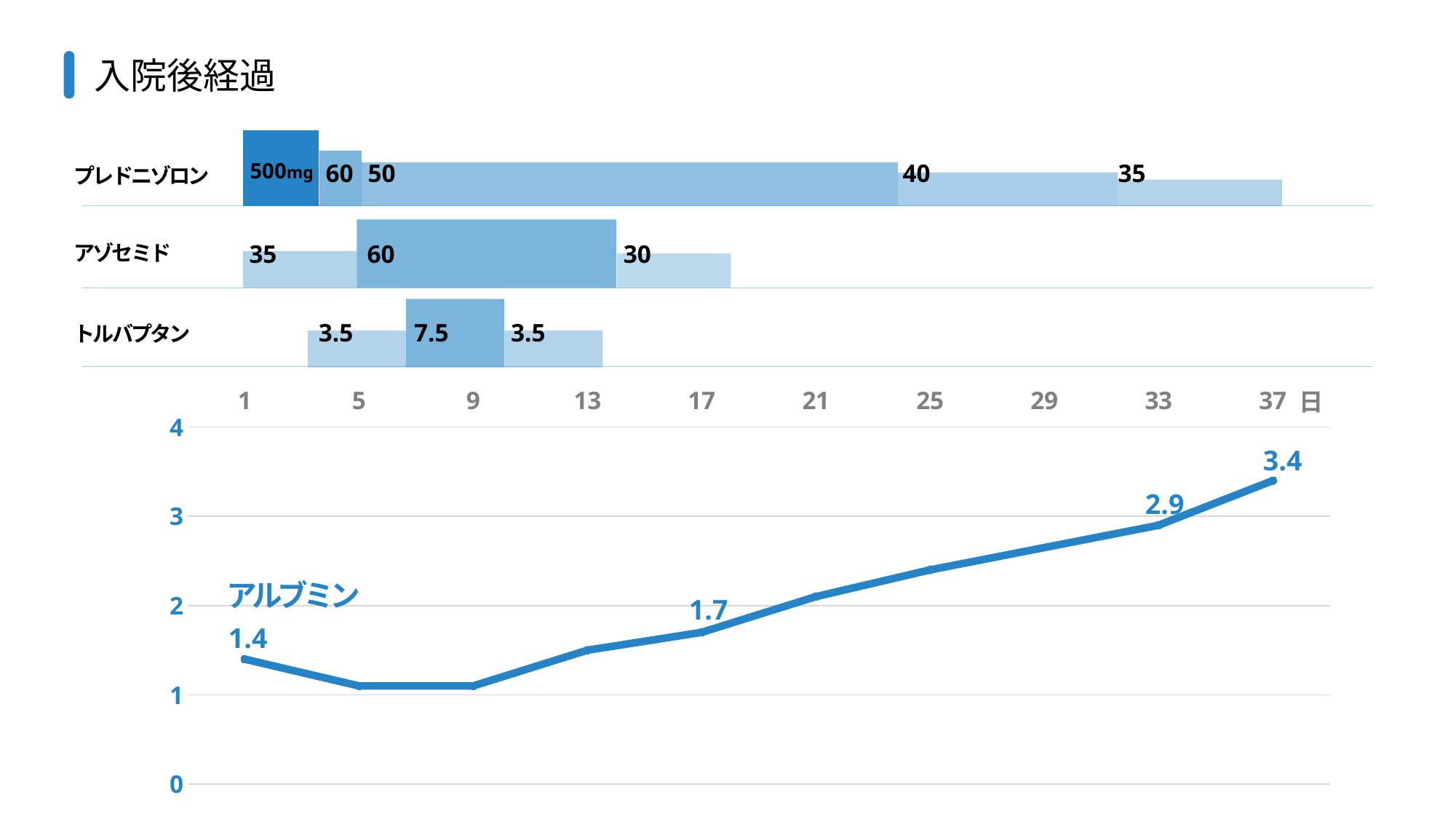
On the bottom line chart, which is larger, the albumin value labeled 2.9 or the one labeled 1.7? 2.9 On the bottom line chart, is the albumin value at day 9 greater or less than 2? less On the bottom line chart, does the albumin value overall rise or fall from day 1 to day 37? rise On the top chart, what is the difference between the highest dose (60) and the lowest dose (30) shown for アゾセミド? 30 On the top chart, how many medications are listed? 3 On the bottom line chart, what is the last labeled albumin (アルブミン) value at day 37? 3.4 On the bottom line chart, what is the first labeled albumin (アルブミン) value? 1.4 On the bottom line chart, what albumin value is labeled near day 17? 1.7 On the bottom line chart, what is the difference between the last labeled albumin value (3.4) and the first labeled value (1.4)? 2.0 On the top chart, what is the highest dose shown for トルバプタン? 7.5 On the top chart, what is the first dose shown for プレドニゾロン? 500mg What kind of chart is the bottom chart showing アルブミン? line chart